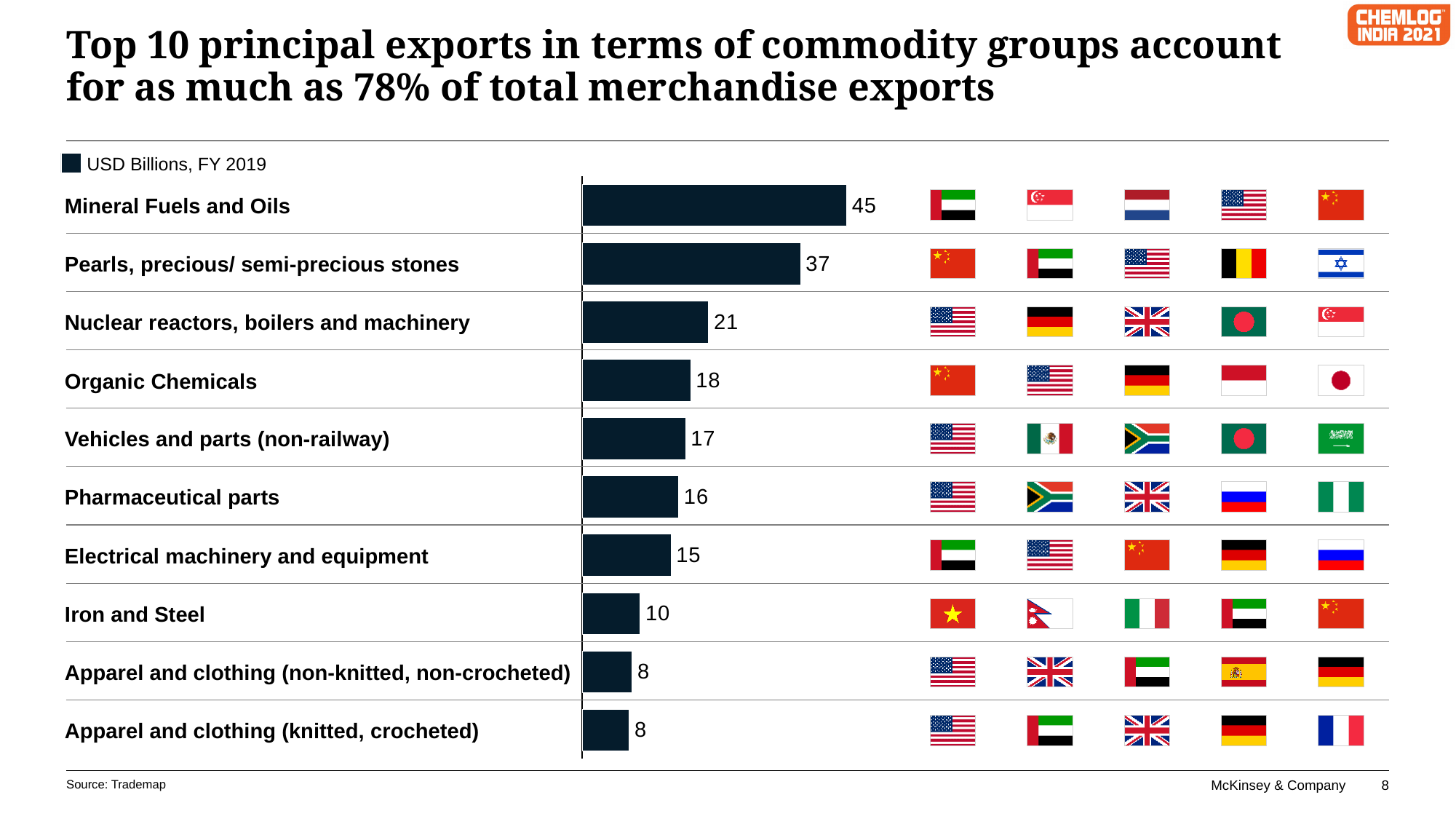
What is the value for Organic Chemicals? 18 What is the difference between Mineral Fuels and Oils and Pearls, precious/ semi-precious stones? 8 How many commodity groups are shown in the chart? 10 Which is larger, Vehicles and parts (non-railway) or Electrical machinery and equipment? Vehicles and parts (non-railway) Which commodity group has the highest value? Mineral Fuels and Oils Which is larger, Pharmaceutical parts or Pearls, precious/ semi-precious stones? Pearls, precious/ semi-precious stones What unit and period does the chart legend state? USD Billions, FY 2019 What is the value for Mineral Fuels and Oils? 45 What kind of chart is shown on the slide? Bar chart What is the value for Iron and Steel? 10 What is the source cited for the chart? Trademap What is the difference between Nuclear reactors, boilers and machinery and Iron and Steel? 11